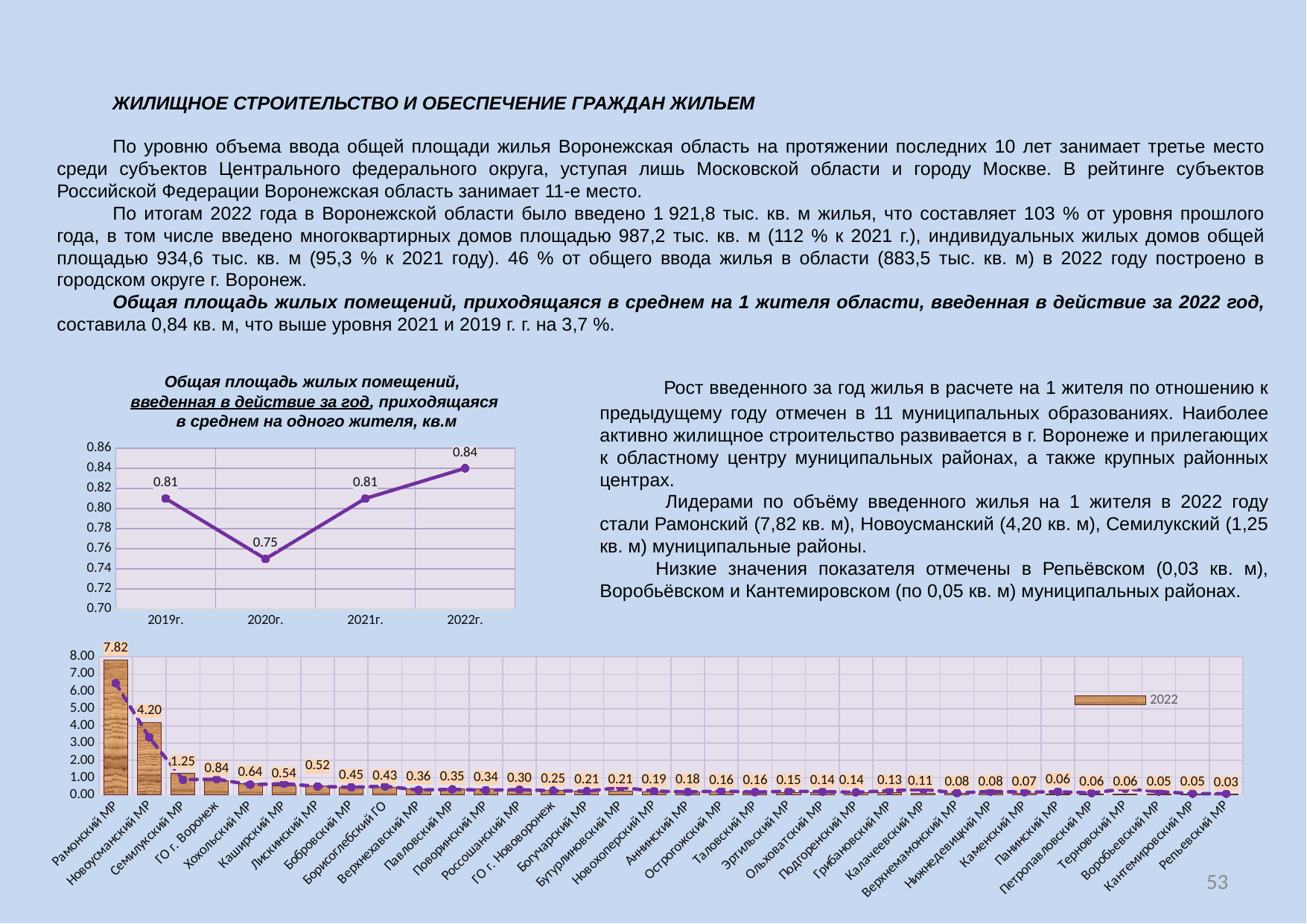
In the line chart at the top left, what is the value for 2020г.? 0.75 In the bar chart at the bottom, which municipality has the highest value? Рамонский МР In the bar chart at the bottom, which municipality has the lowest value? Репьевский МР In the line chart at the top left, which year has the lowest value? 2020г. In the bar chart at the bottom, what is the difference between Рамонский МР and Новоусманский МР? 3.62 In the line chart at the top left, how many years are plotted? 4 What kind of chart is the one at the top left of the slide? Line chart In the line chart at the top left, what is the difference between the 2022г. and 2020г. values? 0.09 In the bar chart at the bottom, what year does the legend entry show? 2022 In the line chart at the top left, what is the value for 2022г.? 0.84 In the bar chart at the bottom, what is the value for Хохольский МР? 0.64 In the bar chart at the bottom, what is the value for Новоусманский МР? 4.20